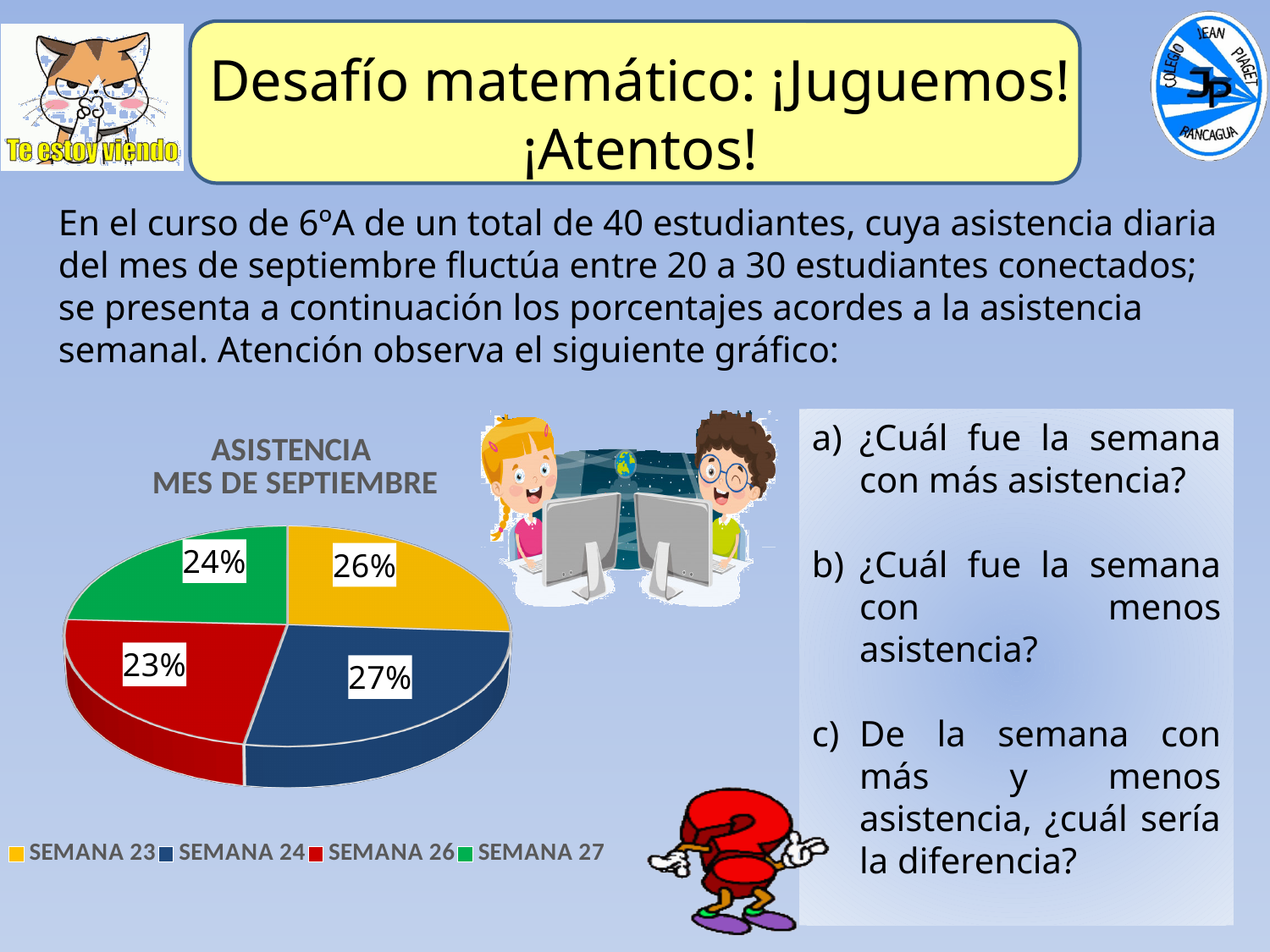
Which week has the largest share of the pie? SEMANA 24 Which week has the smallest share of the pie? SEMANA 26 What percentage does the chart show for SEMANA 24? 27% How many slices does the pie chart have? 4 What percentage does the chart show for SEMANA 27? 24% What is the difference in percentage points between SEMANA 24 and SEMANA 26? 4 Which colour represents SEMANA 26 in the legend? Red What percentage does the chart show for SEMANA 26? 23% What percentage does the chart show for SEMANA 23? 26% Which is larger, the share for SEMANA 23 or the share for SEMANA 27? SEMANA 23 What is the title of the chart? ASISTENCIA MES DE SEPTIEMBRE What kind of chart is shown on the slide? Pie chart